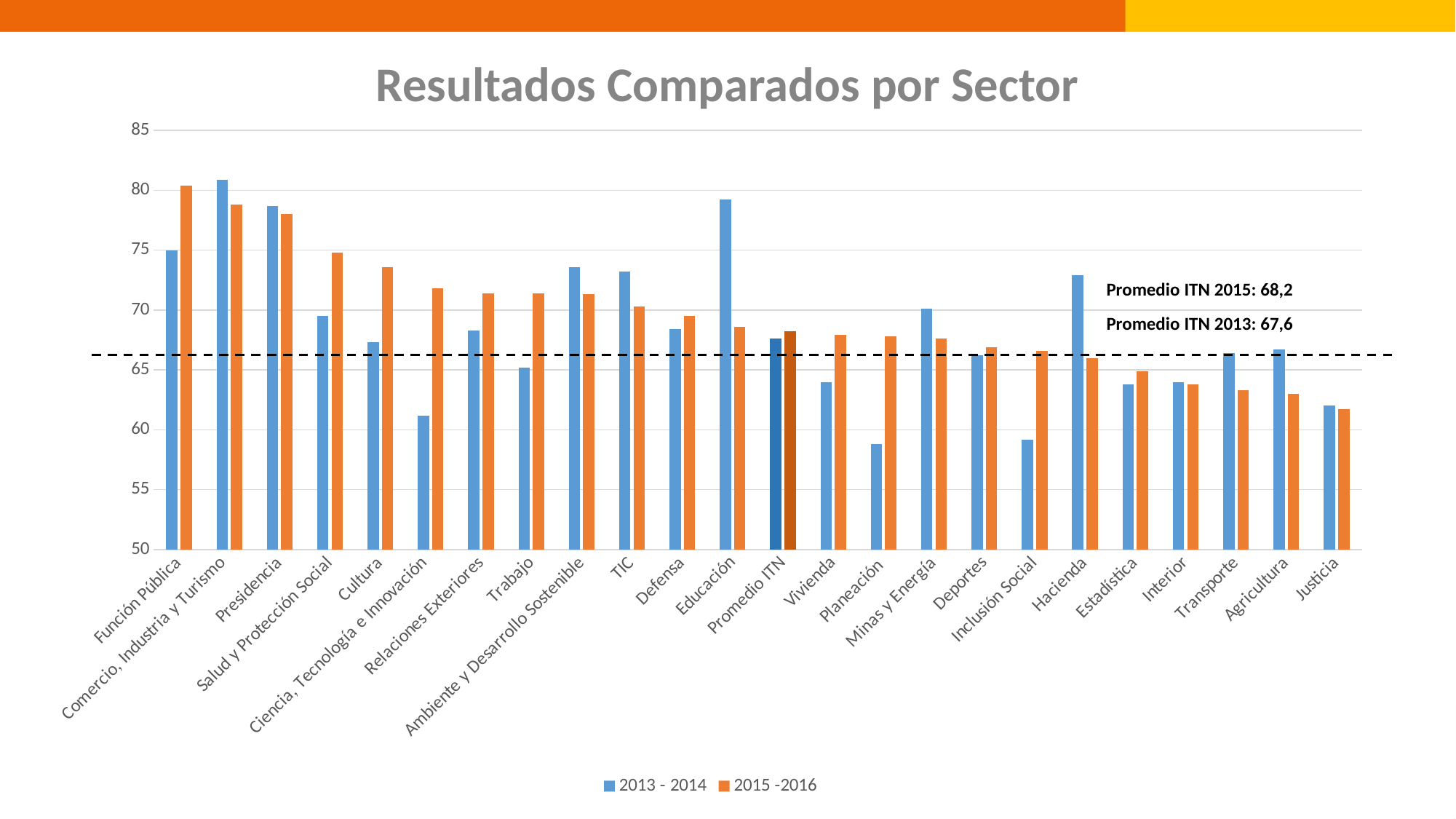
Which category has the lowest value for the 2015 -2016 series? Justicia Is the 2015 -2016 value for Ciencia, Tecnología e Innovación greater or less than 70? greater Is the 2013 - 2014 value for Educación greater or less than 75? greater How many series does the legend list? 2 For Hacienda, which series has the larger value, 2013 - 2014 or 2015 -2016? 2013 - 2014 Which category has the highest value for the 2015 -2016 series? Función Pública Which category has the highest value for the 2013 - 2014 series? Comercio, Industria y Turismo Is the 2013 - 2014 value for Planeación greater or less than 60? less For Función Pública, which series has the larger value, 2013 - 2014 or 2015 -2016? 2015 -2016 What kind of chart is shown on the slide? bar chart How many sector categories are shown on the x axis? 24 What is the Promedio ITN 2015 value stated on the slide? 68,2